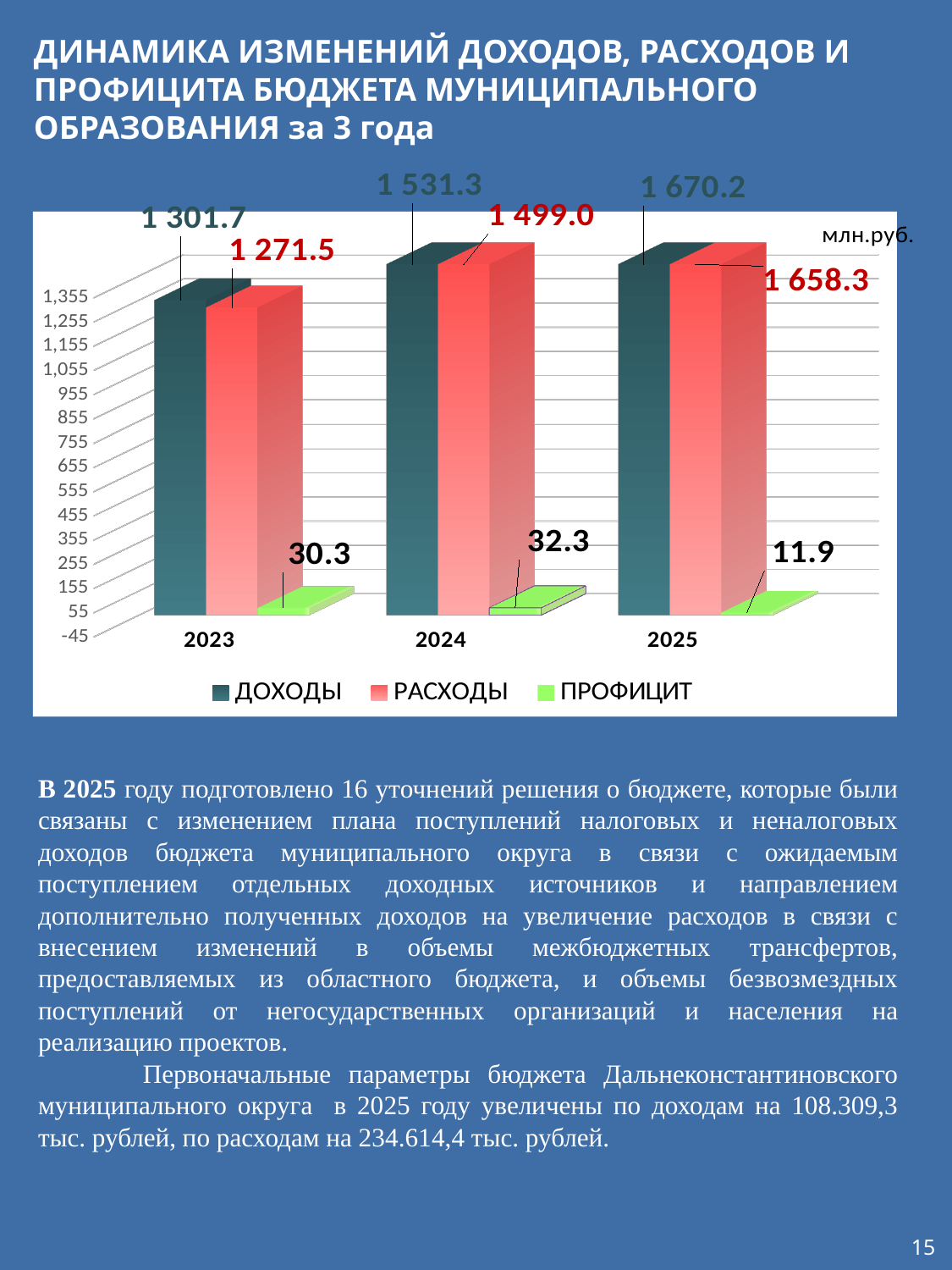
In which year is ДОХОДЫ the highest? 2025 Which is larger in 2024: ДОХОДЫ or РАСХОДЫ? ДОХОДЫ What kind of chart is shown on the slide? bar chart How many years are shown on the x axis? 3 What is the value of ДОХОДЫ for 2024? 1 531.3 Do the values of ДОХОДЫ rise or fall from 2023 to 2025? rise How many series does the legend list? 3 What is the value of ПРОФИЦИТ for 2023? 30.3 Is the value of РАСХОДЫ for 2023 greater or less than 1,155? greater What is the difference between ДОХОДЫ and РАСХОДЫ in 2023? 30.2 In which year is ПРОФИЦИТ the lowest? 2025 What is the value of РАСХОДЫ for 2025? 1 658.3